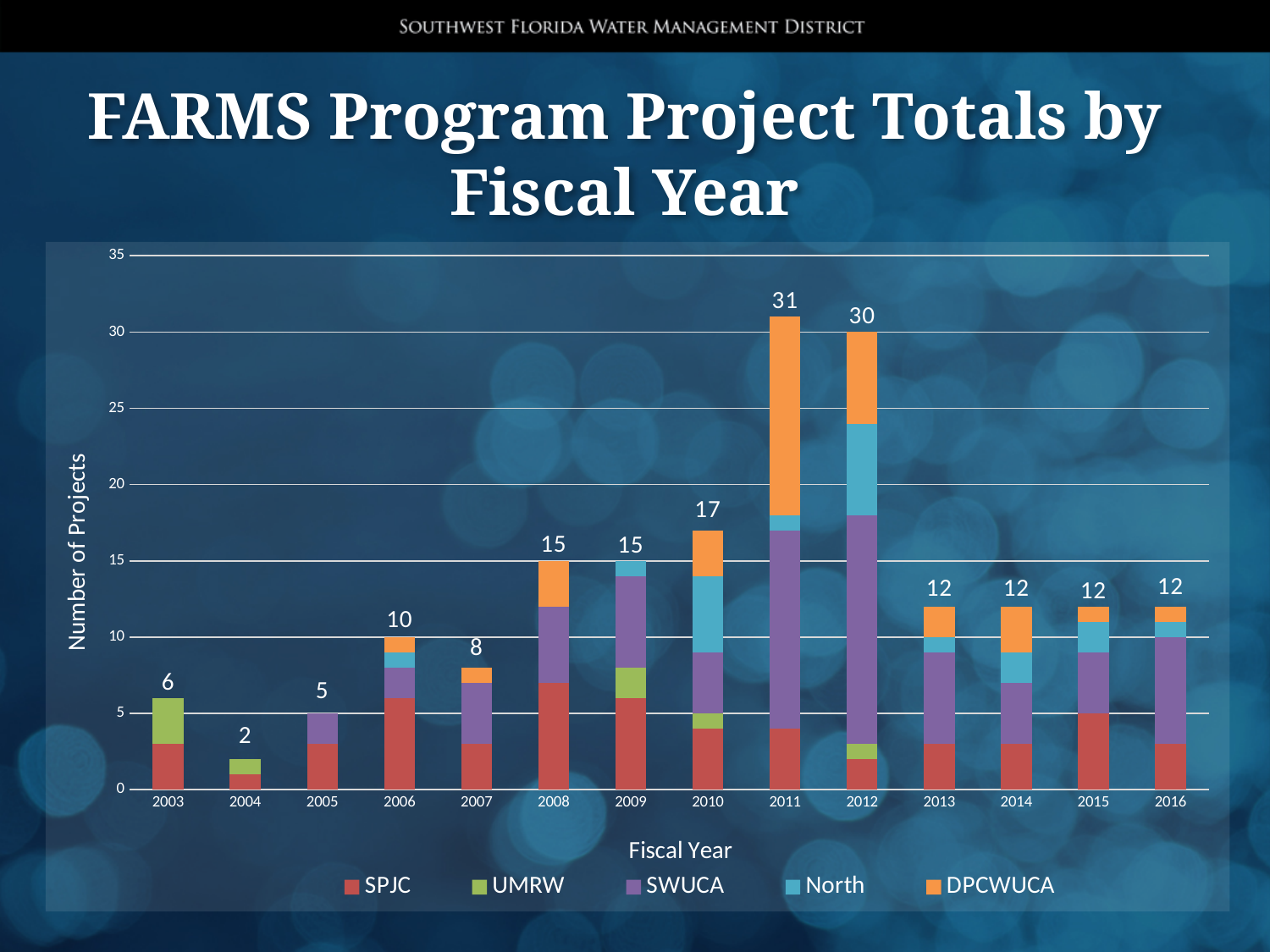
What is the difference between the total number of projects in 2010 and in 2006? 7 What is the difference between the total number of projects in 2011 and in 2012? 1 What is the label of the y axis? Number of Projects Which fiscal year has a larger total number of projects, 2008 or 2010? 2010 How many series does the legend list? 5 Which fiscal year has the lowest total number of projects? 2004 What is the total number of projects shown for fiscal year 2007? 8 What kind of chart is shown on the slide? Stacked bar chart What is the total number of projects shown for fiscal year 2011? 31 How many fiscal years are shown on the x axis? 14 Is the total number of projects for 2012 greater or less than 25? greater Which fiscal year has the highest total number of projects? 2011